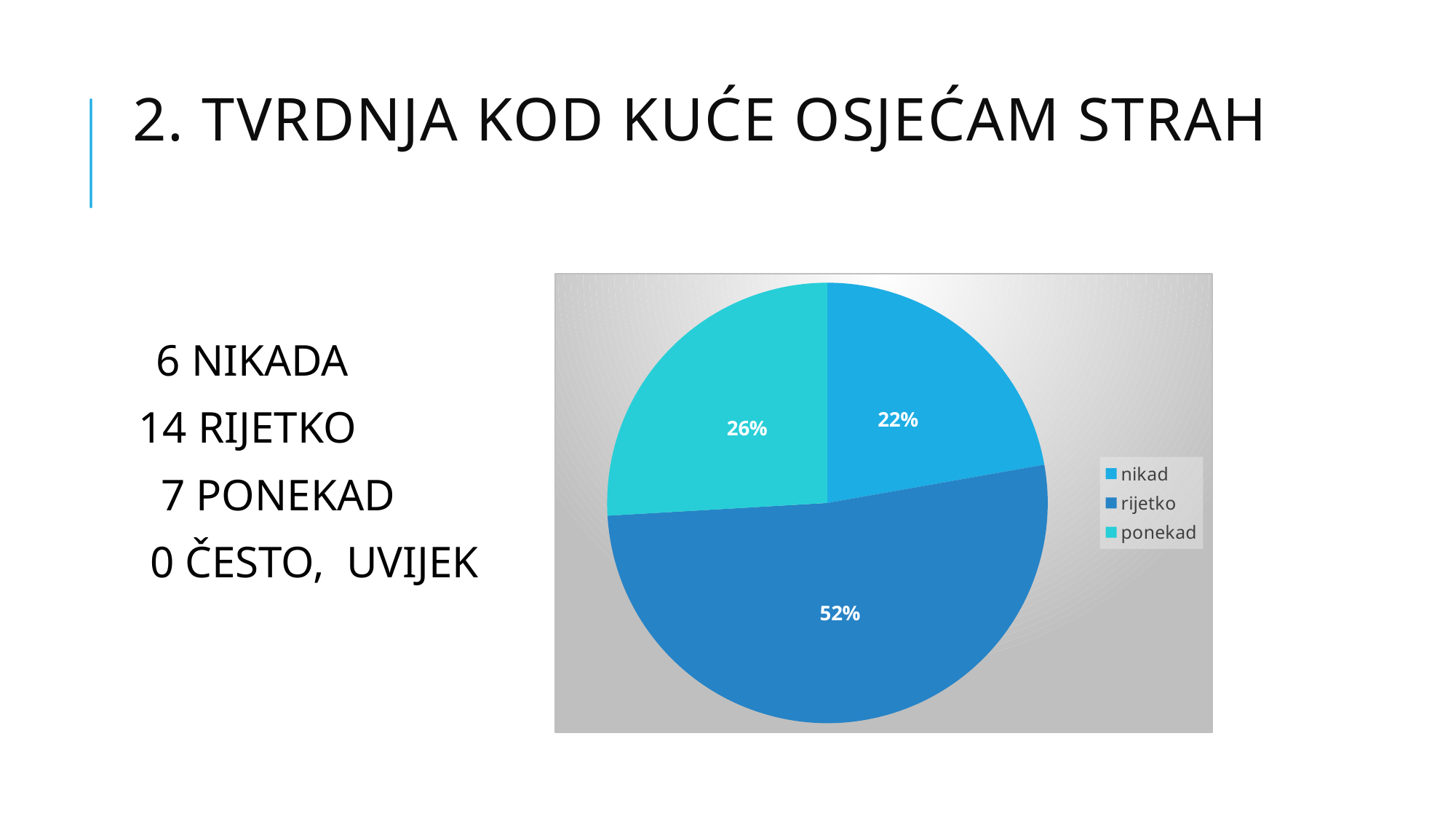
What is the difference in percentage points between the "rijetko" and "ponekad" slices? 26 What kind of chart is shown on the slide? pie chart How many slices does the pie chart have? 3 What share of the pie does the "rijetko" slice represent? 52% Which legend entry is shown in the lightest (turquoise) colour? ponekad Which slice is larger, "ponekad" or "nikad"? ponekad What share of the pie does the "nikad" slice represent? 22% What share of the pie does the "ponekad" slice represent? 26% Which category has the largest slice of the pie? rijetko How many entries does the legend list? 3 Is the share for "rijetko" greater or less than 50%? greater Which category has the smallest slice of the pie? nikad